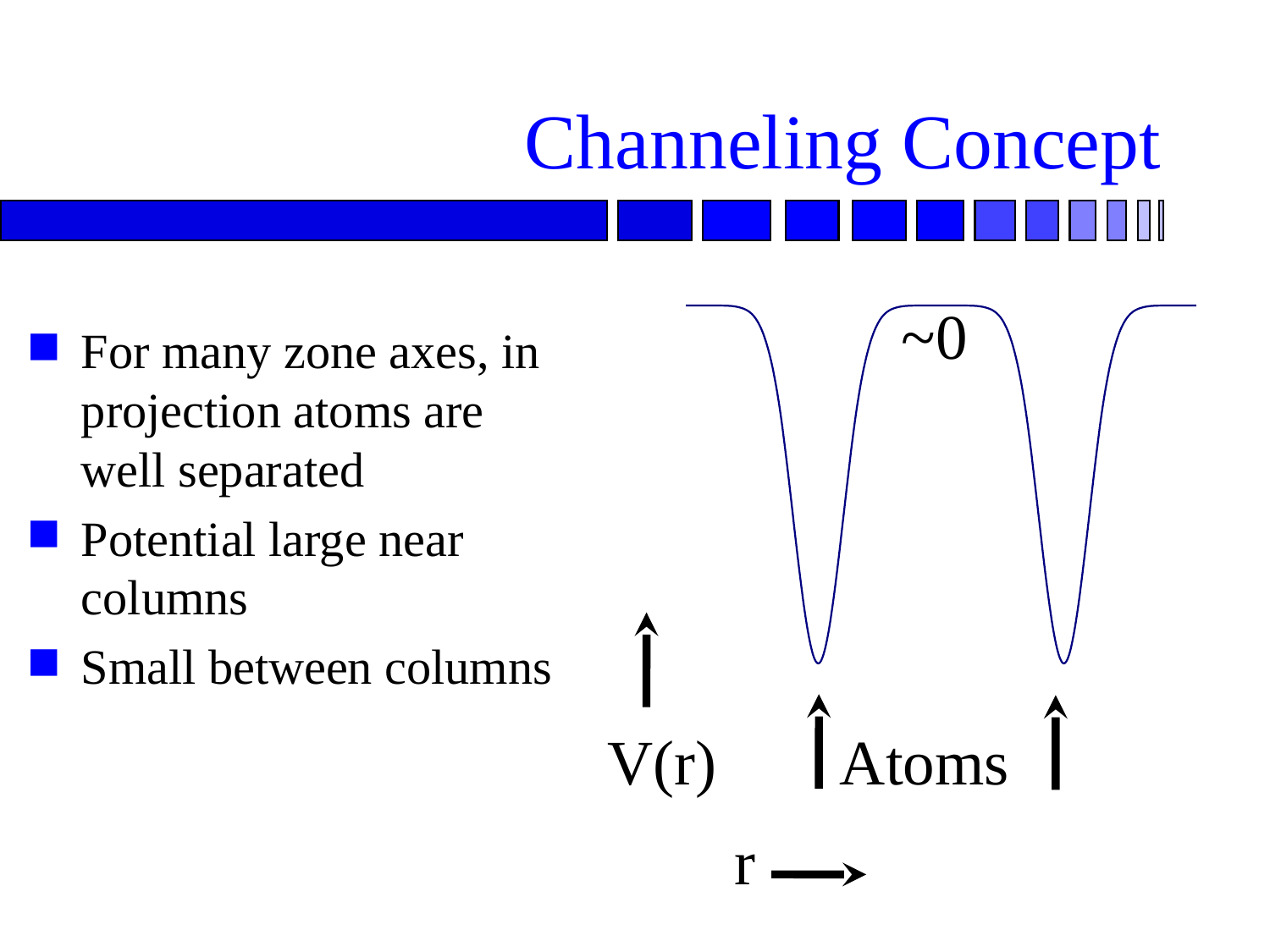
How many minima (dips) does the V(r) curve show? 2 What word labels the arrows pointing up at the two dips of the curve? Atoms What label is given to the horizontal axis of the diagram on the right? r How many atom positions are marked with arrows below the curve in the diagram? 2 What value is written above the curve between the two dips? ~0 What kind of chart is the diagram on the right? line chart What label is given to the vertical axis of the diagram on the right? V(r)